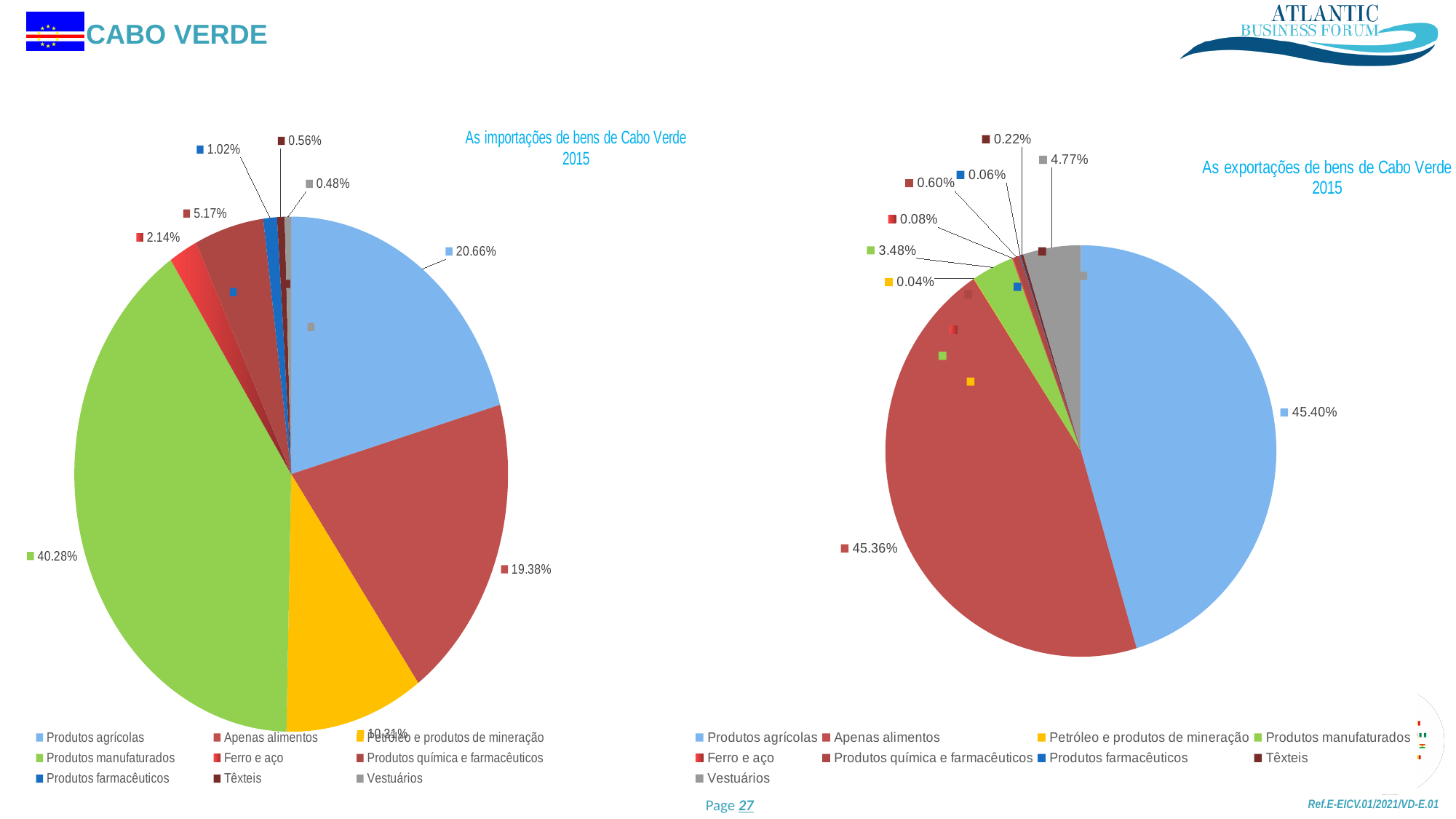
In the chart 'As exportações de bens de Cabo Verde 2015', what is the share for Vestuários? 4.77% How many categories does the legend of 'As importações de bens de Cabo Verde 2015' list? 9 In the chart 'As importações de bens de Cabo Verde 2015', which category has the largest share? Produtos manufaturados In the chart 'As importações de bens de Cabo Verde 2015', what is the share for Apenas alimentos? 19.38% In the chart 'As importações de bens de Cabo Verde 2015', what is the difference between the shares of Produtos agrícolas and Apenas alimentos? 1.28% In the chart 'As exportações de bens de Cabo Verde 2015', which is larger: Produtos manufaturados or Vestuários? Vestuários In the chart 'As importações de bens de Cabo Verde 2015', which category has the smallest share? Vestuários In the chart 'As importações de bens de Cabo Verde 2015', what is the share for Produtos manufaturados? 40.28% In the chart 'As exportações de bens de Cabo Verde 2015', what is the share for Produtos agrícolas? 45.40% In the chart 'As exportações de bens de Cabo Verde 2015', which category has the smallest share? Petróleo e produtos de mineração In the chart 'As importações de bens de Cabo Verde 2015', which is larger: Ferro e aço or Produtos química e farmacêuticos? Produtos química e farmacêuticos What kind of chart is 'As importações de bens de Cabo Verde 2015'? pie chart